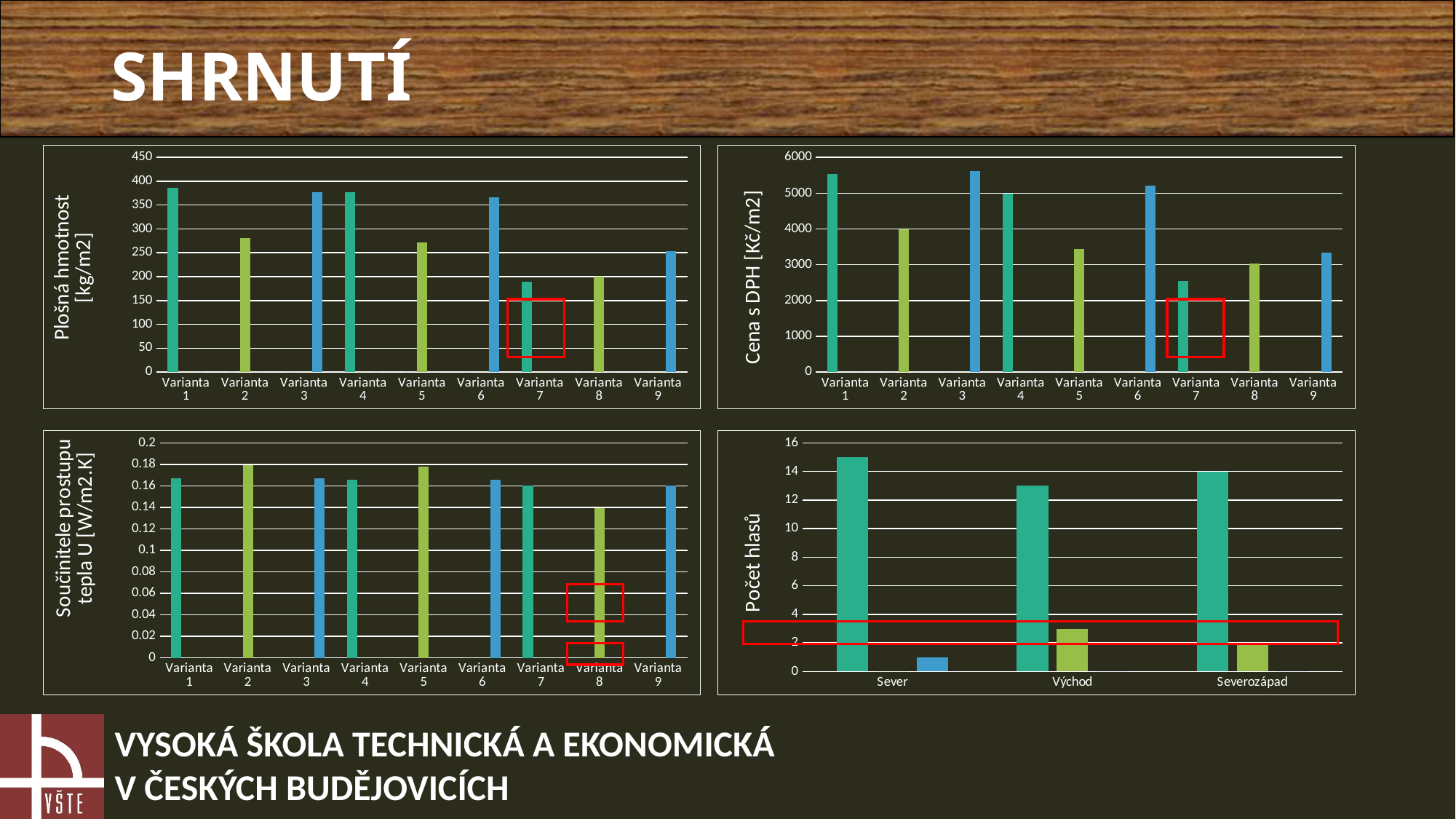
How many categories (Varianta) are shown on the top-left chart (Plošná hmotnost [kg/m2])? 9 On the bottom-left chart (Součinitele prostupu tepla U [W/m2.K]), is the value for Varianta 8 greater or less than 0.16? less On the bottom-left chart (Součinitele prostupu tepla U [W/m2.K]), which Varianta has the lowest value? Varianta 8 On the top-right chart (Cena s DPH [Kč/m2]), which Varianta has the lowest value? Varianta 7 What is the label of the vertical axis on the bottom-right chart? Počet hlasů On the top-left chart (Plošná hmotnost [kg/m2]), is the value for Varianta 9 greater or less than 300? less On the top-right chart (Cena s DPH [Kč/m2]), which is larger, the value for Varianta 4 or Varianta 5? Varianta 4 On the top-left chart (Plošná hmotnost [kg/m2]), is the value for Varianta 1 greater or less than 350? greater How many categories are shown on the x axis of the bottom-right chart (Počet hlasů)? 3 On the top-left chart (Plošná hmotnost [kg/m2]), which is larger, the value for Varianta 2 or Varianta 7? Varianta 2 What kind of chart is the top-left chart (Plošná hmotnost [kg/m2])? bar chart